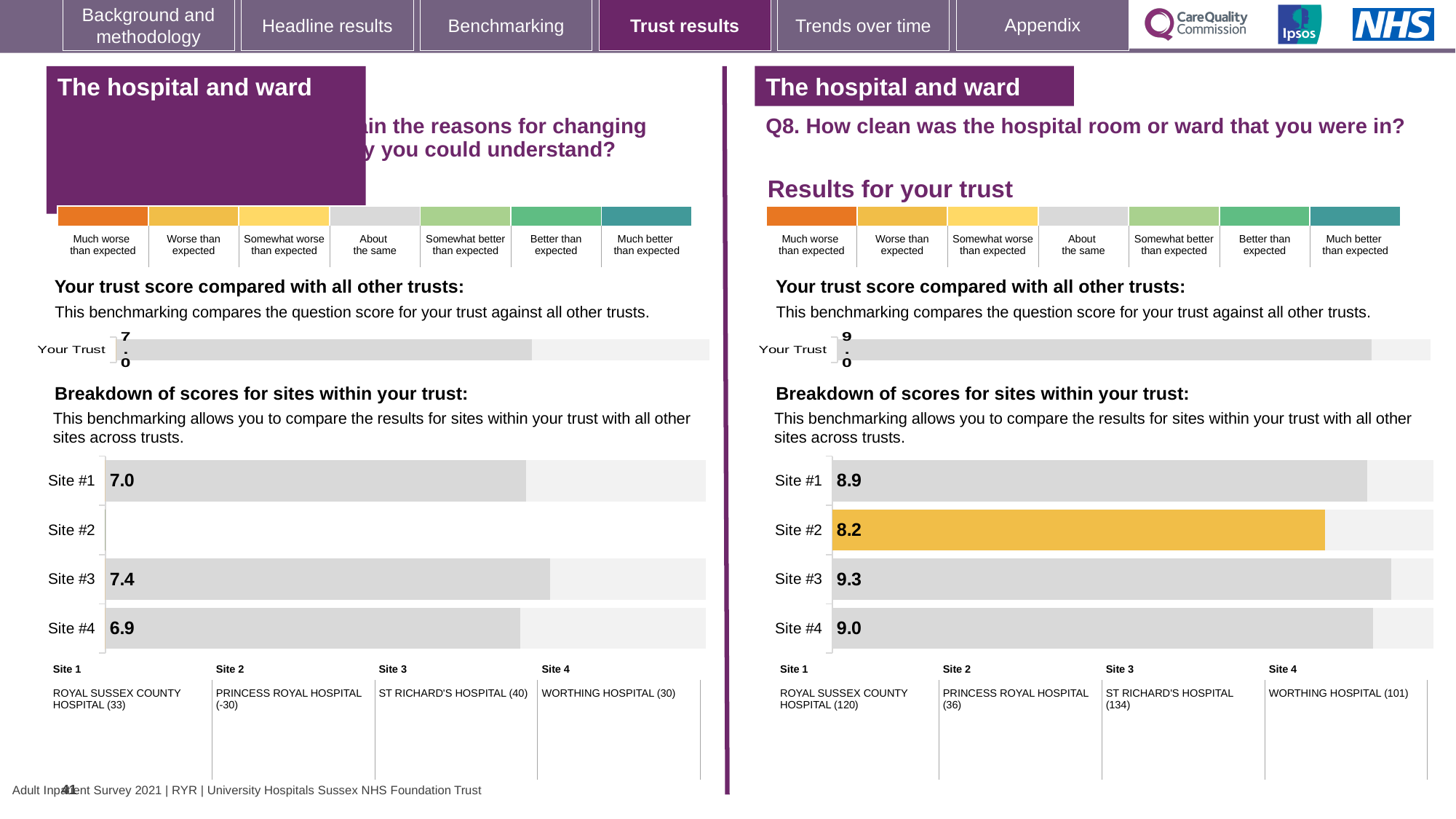
In the Q8 chart on the right, which site has the lowest score? Site #2 In the site breakdown chart on the left-hand side of the slide, what is the score for Site #3? 7.4 What kind of chart is used to show the breakdown of scores for sites within the trust? Bar chart In the Q8 'How clean was the hospital room or ward' chart on the right, what is the score for Site #3? 9.3 In the Q8 chart on the right, which site has the highest score? Site #3 In the Q8 chart on the right, what is the score for Site #2? 8.2 In the Q8 chart on the right, which site's bar is coloured yellow rather than grey? Site #2 In the Q8 chart on the right, what is the difference between the scores for Site #3 and Site #2? 1.1 In the Q8 chart on the right, what is the 'Your Trust' score? 9.0 In the site breakdown chart on the left-hand side of the slide, what is the score for Site #4? 6.9 In the site breakdown chart on the left-hand side of the slide, is the score for Site #1 or Site #4 larger? Site #1 In the site breakdown chart on the left-hand side of the slide, which site has the highest score? Site #3